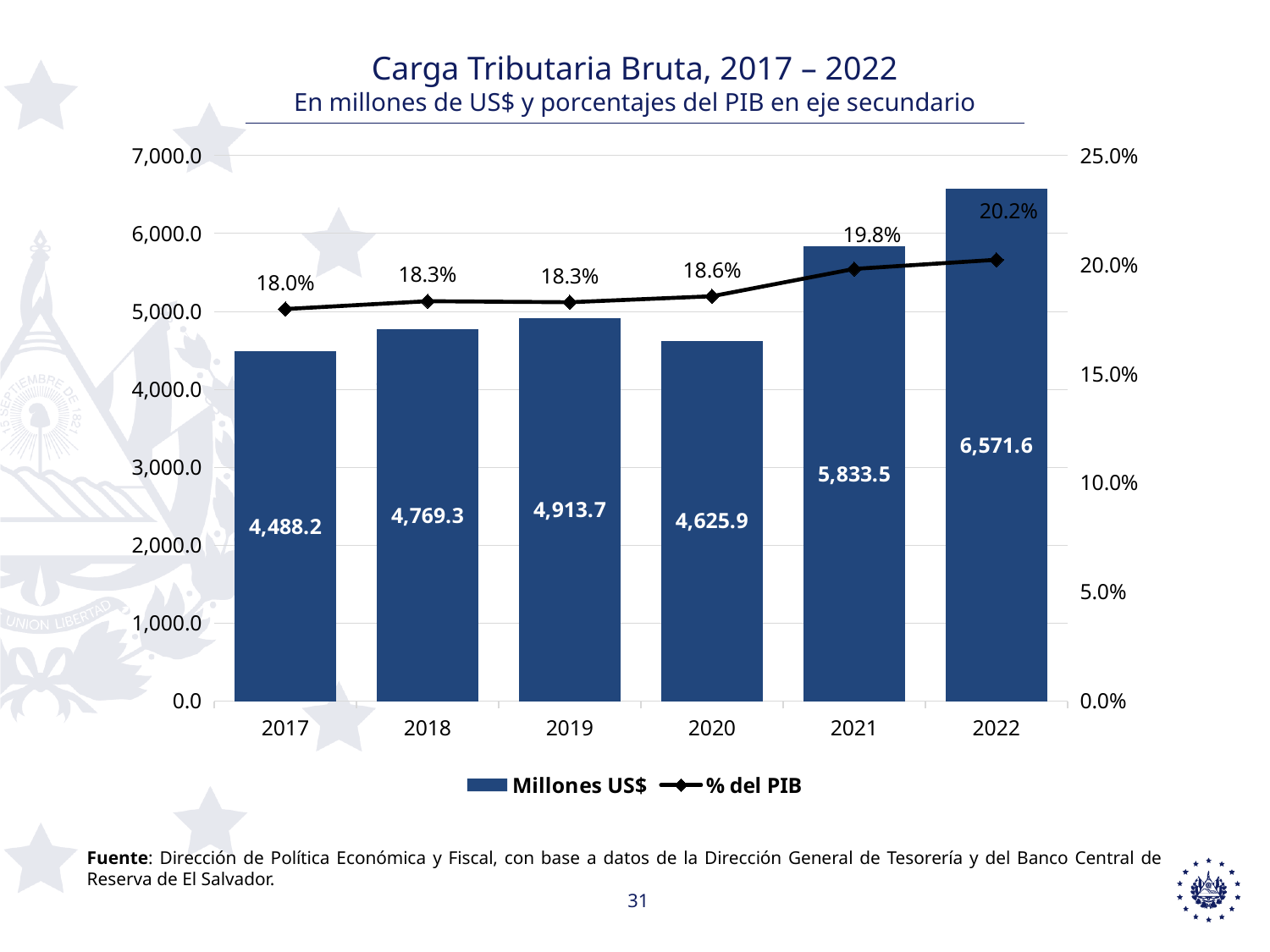
How many years are shown on the x axis? 6 What is the % del PIB value for 2021? 19.8% What is the value of Millones US$ for 2019? 4,913.7 What is the value of Millones US$ for 2017? 4,488.2 How many series does the legend list? 2 What kind of chart is used to show the Millones US$ series? bar chart Is the Millones US$ value for 2021 greater or less than 5,000.0? greater Which year has a larger Millones US$ value, 2018 or 2020? 2018 What is the title of the chart? Carga Tributaria Bruta, 2017 – 2022 Which year has the lowest Millones US$ value? 2017 Which year has the highest Millones US$ value? 2022 What is the difference in Millones US$ between 2022 and 2021? 738.1